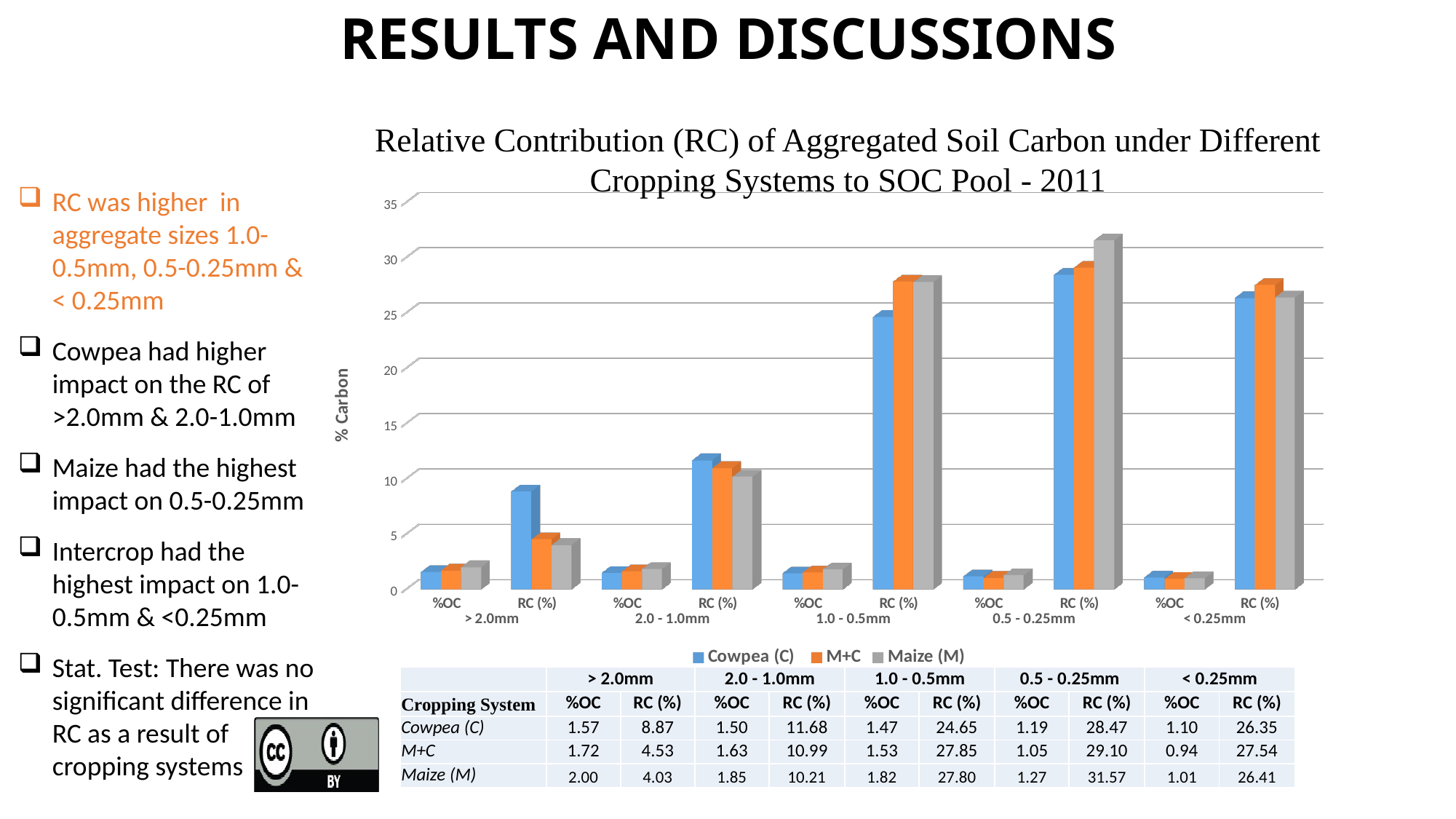
Which is larger in the 2.0 - 1.0mm aggregate size: the RC (%) for Cowpea (C) or for Maize (M)? Cowpea (C) What is the label on the vertical axis of the chart? % Carbon What is the %OC value for M+C in the 1.0 - 0.5mm aggregate size? 1.53 What type of chart is shown on the slide? bar chart Is the RC (%) value for Maize (M) in the 0.5 - 0.25mm aggregate size greater or less than 30? greater How many aggregate size groups are shown along the x axis? 5 What is the difference between the RC (%) of Cowpea (C) and M+C in the > 2.0mm aggregate size? 4.34 Which cropping system has the highest RC (%) in the 0.5 - 0.25mm aggregate size? Maize (M) How many series does the chart legend list? 3 What is the RC (%) value for Maize (M) in the 0.5 - 0.25mm aggregate size? 31.57 What is the RC (%) value for Cowpea (C) in the > 2.0mm aggregate size? 8.87 Which cropping system has the lowest RC (%) in the > 2.0mm aggregate size? Maize (M)